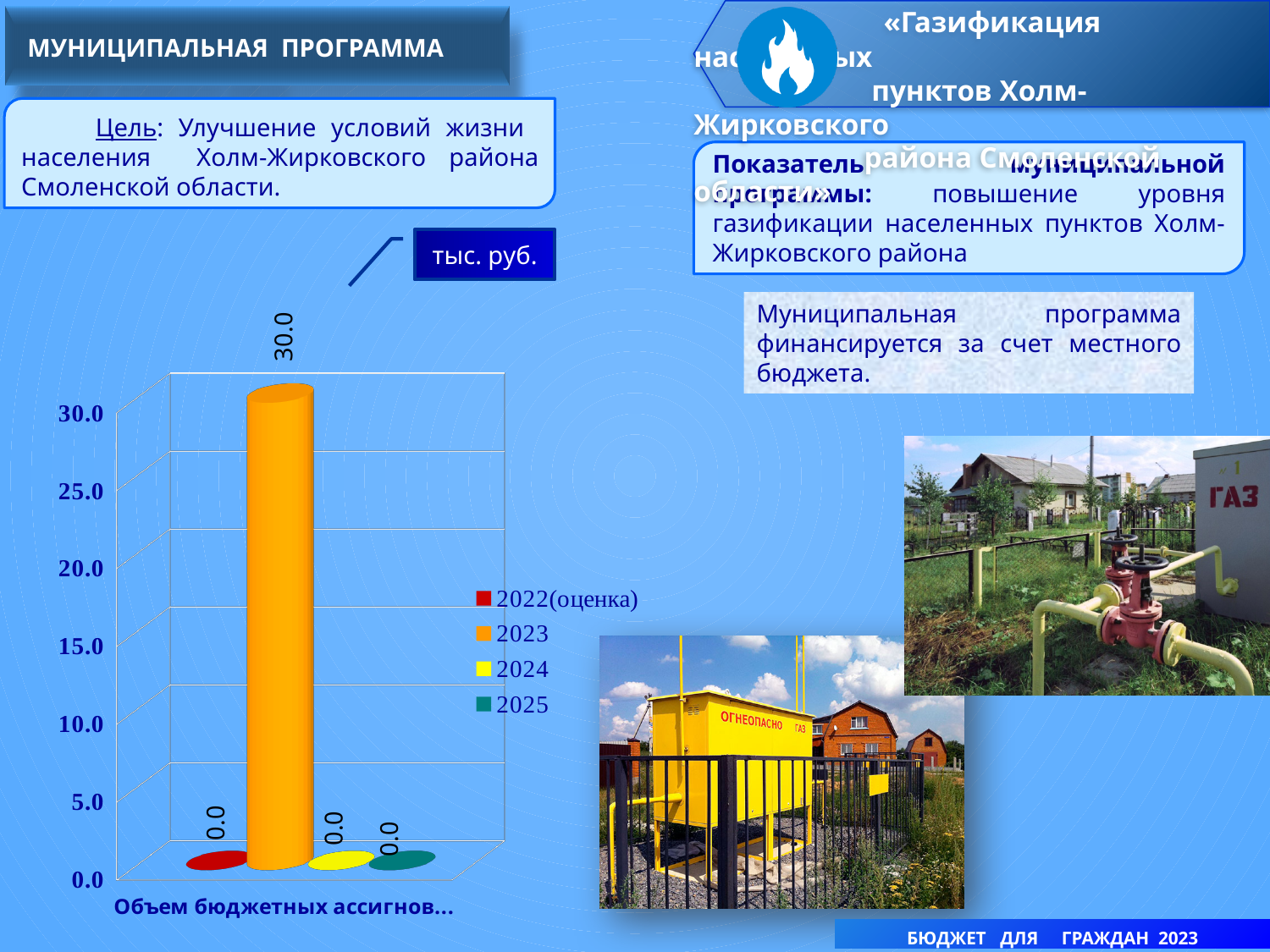
What is the value for 2022(оценка) on the chart? 0.0 Which series has the highest value on the chart? 2023 Is the value for 2023 greater or less than 25.0? greater How many series does the legend list? 4 What colour is the bar for 2023 in the chart? orange What kind of chart is shown on the slide? bar chart What is the value for 2025 on the chart? 0.0 What unit of measurement is indicated for the chart values? тыс. руб. What is the difference between the values for 2023 and 2024? 30.0 What is the value for 2023 on the chart? 30.0 What is the value for 2024 on the chart? 0.0 Which is larger, the value for 2023 or the value for 2025? 2023